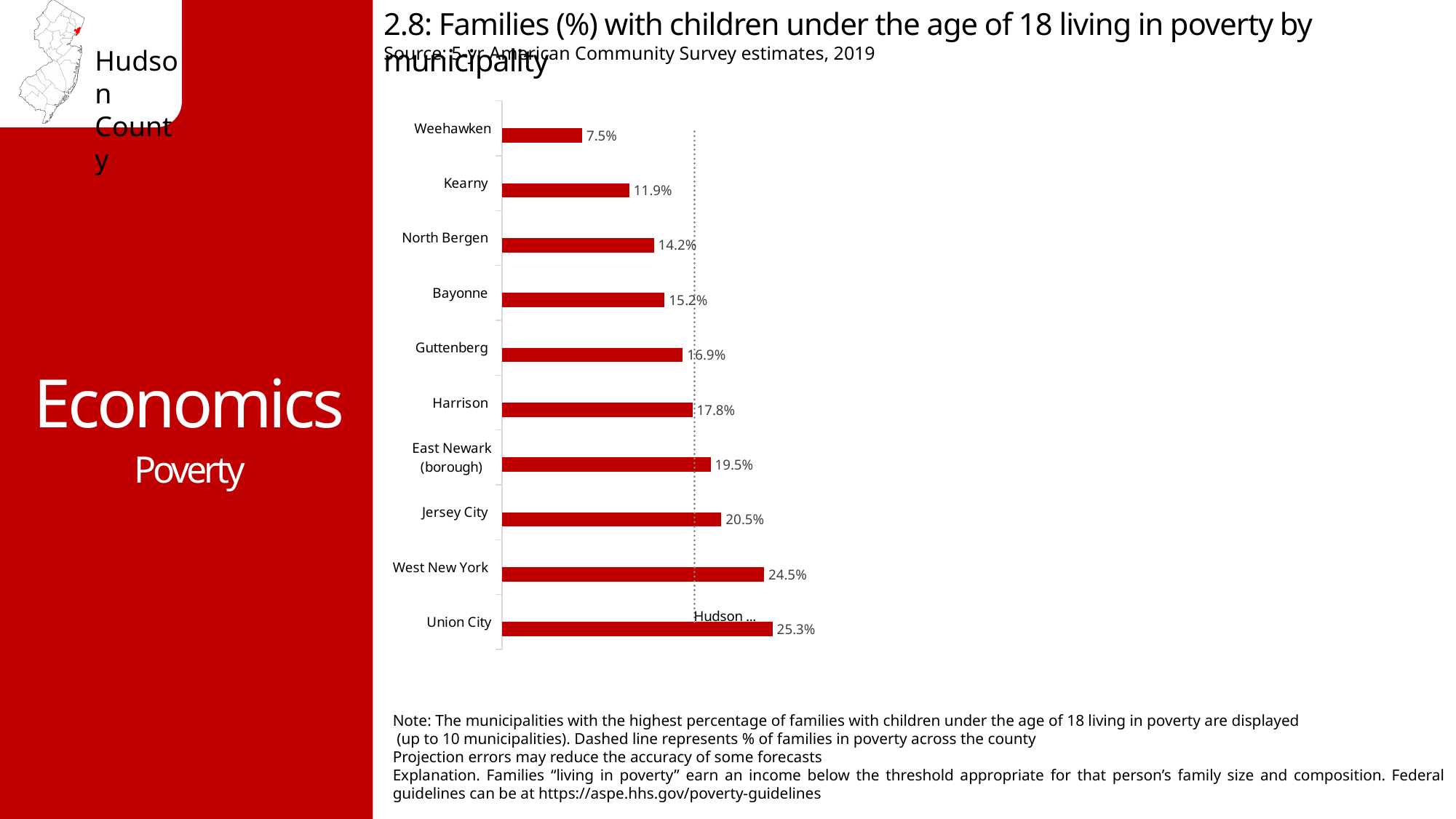
What is the value shown for Weehawken? 7.5% What is the value shown for Guttenberg? 16.9% What percentage of families with children under 18 are living in poverty in Union City? 25.3% Which municipality has the lowest percentage of families with children under 18 living in poverty? Weehawken Which municipality has the highest percentage of families with children under 18 living in poverty? Union City Which has a higher value, Bayonne or Harrison? Harrison What is the value shown for East Newark (borough)? 19.5% What is the value shown for Jersey City? 20.5% How many municipalities are shown in the chart? 10 What type of chart is used on this slide? Bar chart What is the difference between the values for West New York and Kearny? 12.6% According to the note, what does the dashed line on the chart represent? % of families in poverty across the county